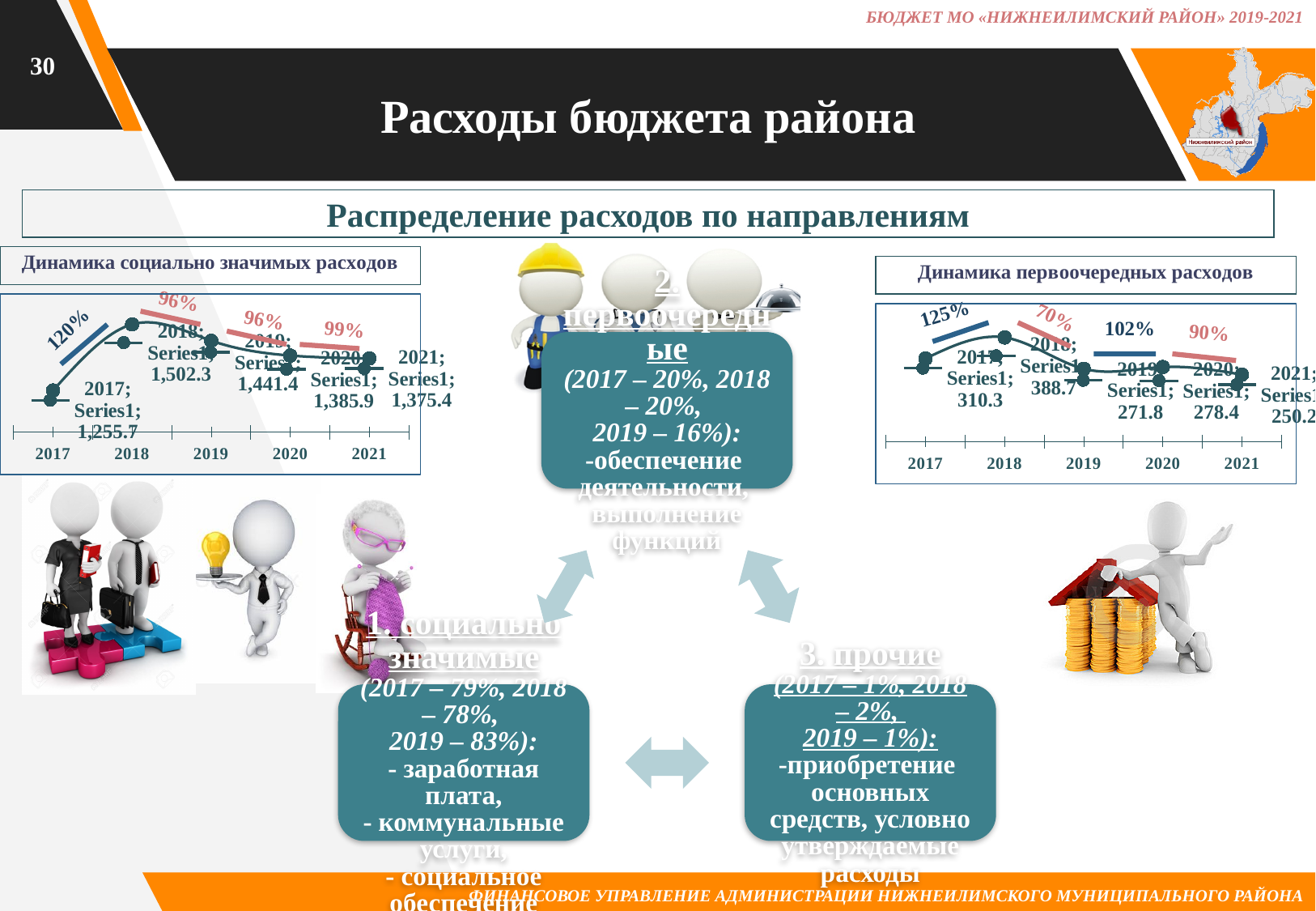
How many years are plotted in the chart 'Динамика первоочередных расходов'? 5 What type of chart is 'Динамика социально значимых расходов'? line chart In the chart 'Динамика социально значимых расходов', what is the difference between the 2018 and 2017 values? 246.6 In the chart 'Динамика социально значимых расходов', what is the value for 2017? 1,255.7 In the chart 'Динамика социально значимых расходов', do the values rise or fall from 2018 to 2021? fall In the chart 'Динамика социально значимых расходов', which year has the highest value? 2018 In the chart 'Динамика социально значимых расходов', what is the value for 2018? 1,502.3 In the chart 'Динамика первоочередных расходов', which is larger, the value for 2017 or the value for 2020? 2017 In the chart 'Динамика первоочередных расходов', which year has the highest value? 2018 In the chart 'Динамика социально значимых расходов', which year has the lowest value? 2017 In the chart 'Динамика первоочередных расходов', what is the value for 2019? 271.8 In the chart 'Динамика первоочередных расходов', what is the value for 2018? 388.7